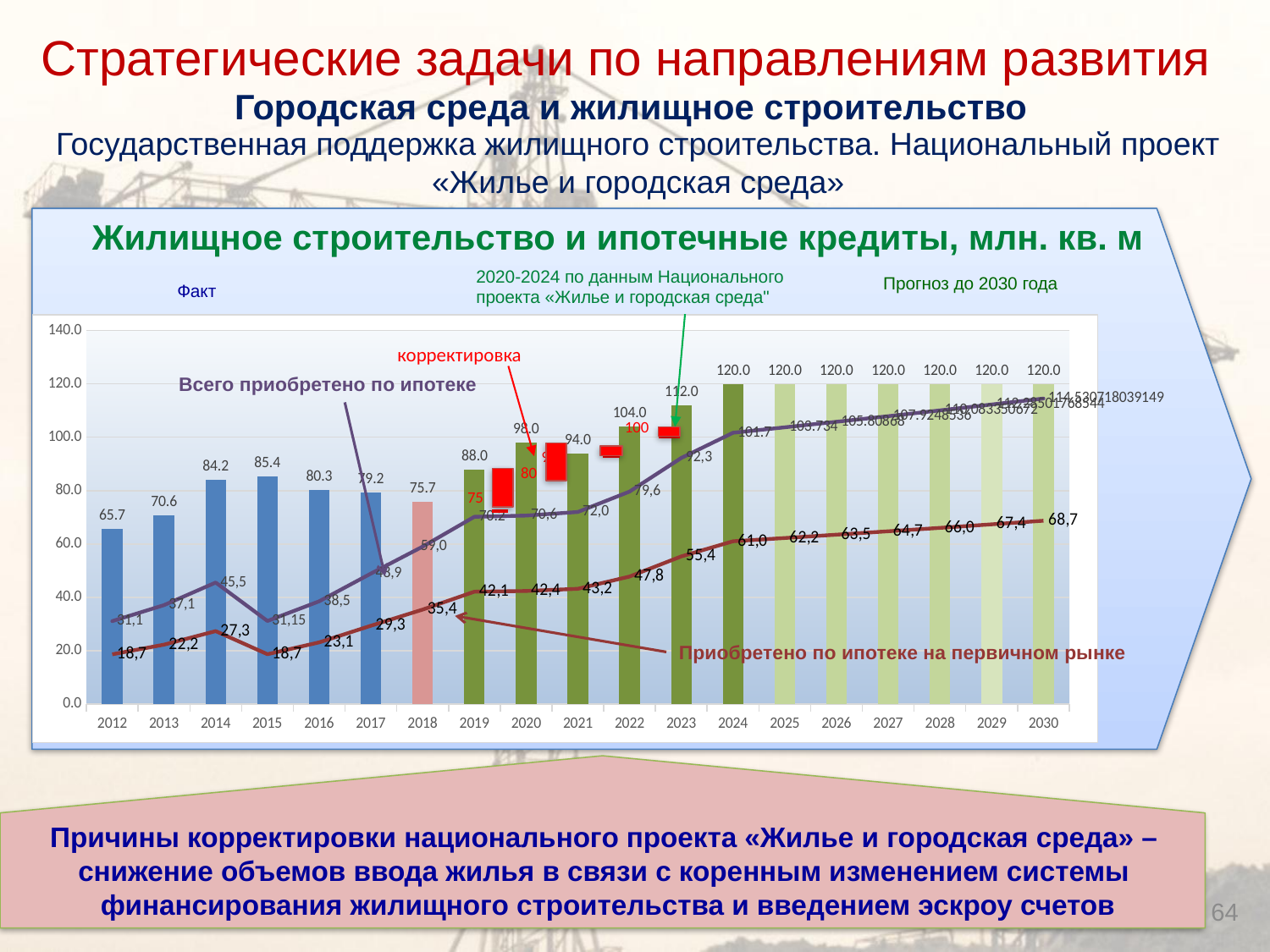
Which bar is taller, 2020 or 2021? 2020 Does the "Приобретено по ипотеке на первичном рынке" line rise or fall from 2019 to 2030? rise What is the value of the "Приобретено по ипотеке на первичном рынке" line for 2023? 55,4 How many years are shown on the x axis of the chart? 19 Among the years 2012 to 2018, which year has the highest bar value? 2015 What is the value of the "Приобретено по ипотеке на первичном рынке" line for 2030? 68,7 What is the difference between the bar values for 2023 and 2022? 8.0 Which year has the lowest bar value in the chart? 2012 Is the bar value for 2019 greater or less than 80? greater What is the value of the bar for 2023? 112.0 What is the value of the bar for 2012 in the chart "Жилищное строительство и ипотечные кредиты, млн. кв. м"? 65.7 What is the difference between the "Приобретено по ипотеке на первичном рынке" values for 2030 and 2012? 50,0